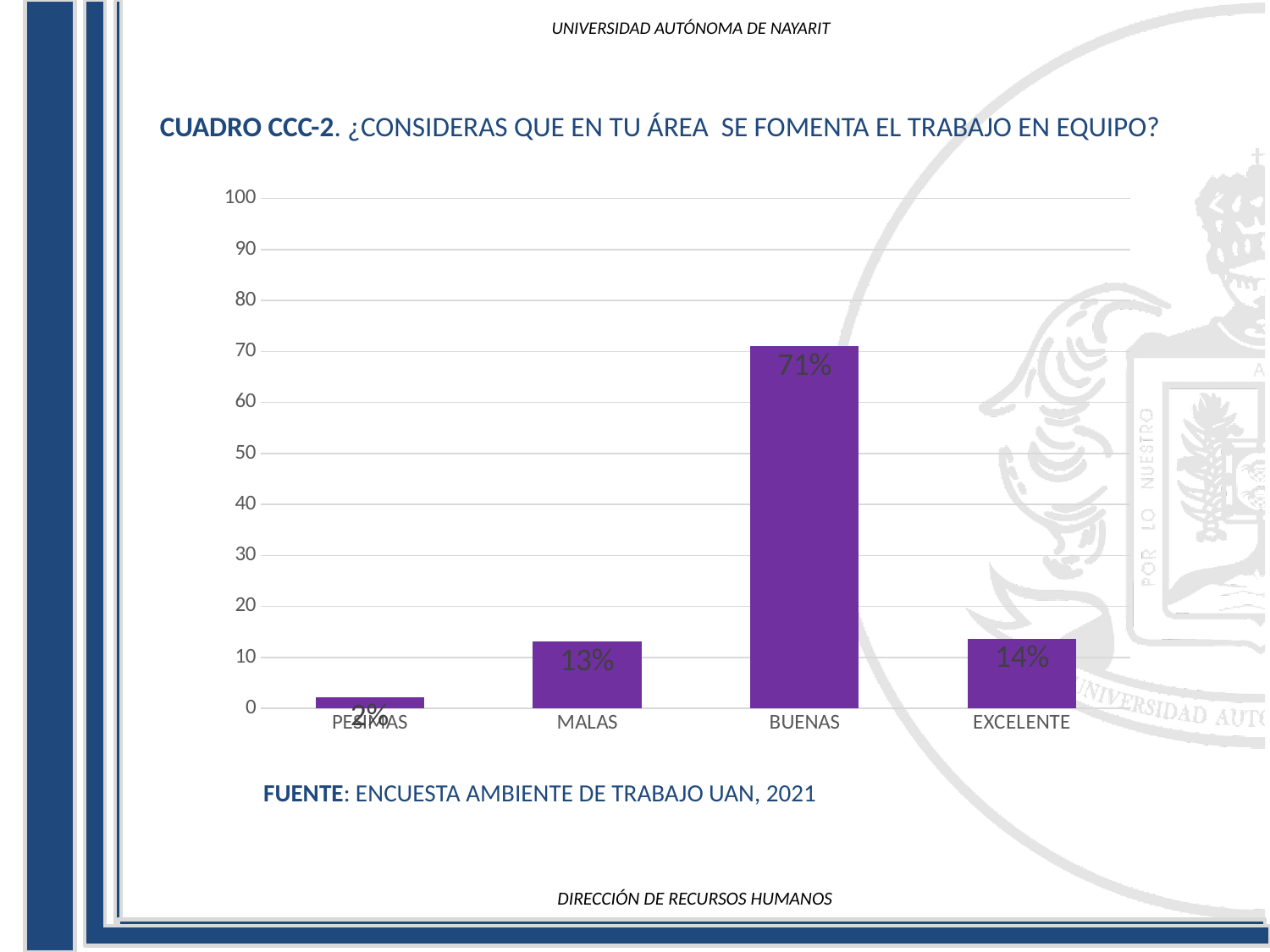
How many categories are shown on the x axis? 4 What source is cited below the chart? ENCUESTA AMBIENTE DE TRABAJO UAN, 2021 What is the value for EXCELENTE? 14% What kind of chart is shown on the slide? bar chart What is the value for MALAS? 13% Which is larger, the value for MALAS or the value for EXCELENTE? EXCELENTE Is the value for BUENAS greater or less than 50? greater Which category has the highest value? BUENAS What is the value for PESIMAS? 2% Which category has the lowest value? PESIMAS What is the difference between the values for BUENAS and EXCELENTE? 57% What is the value for BUENAS? 71%